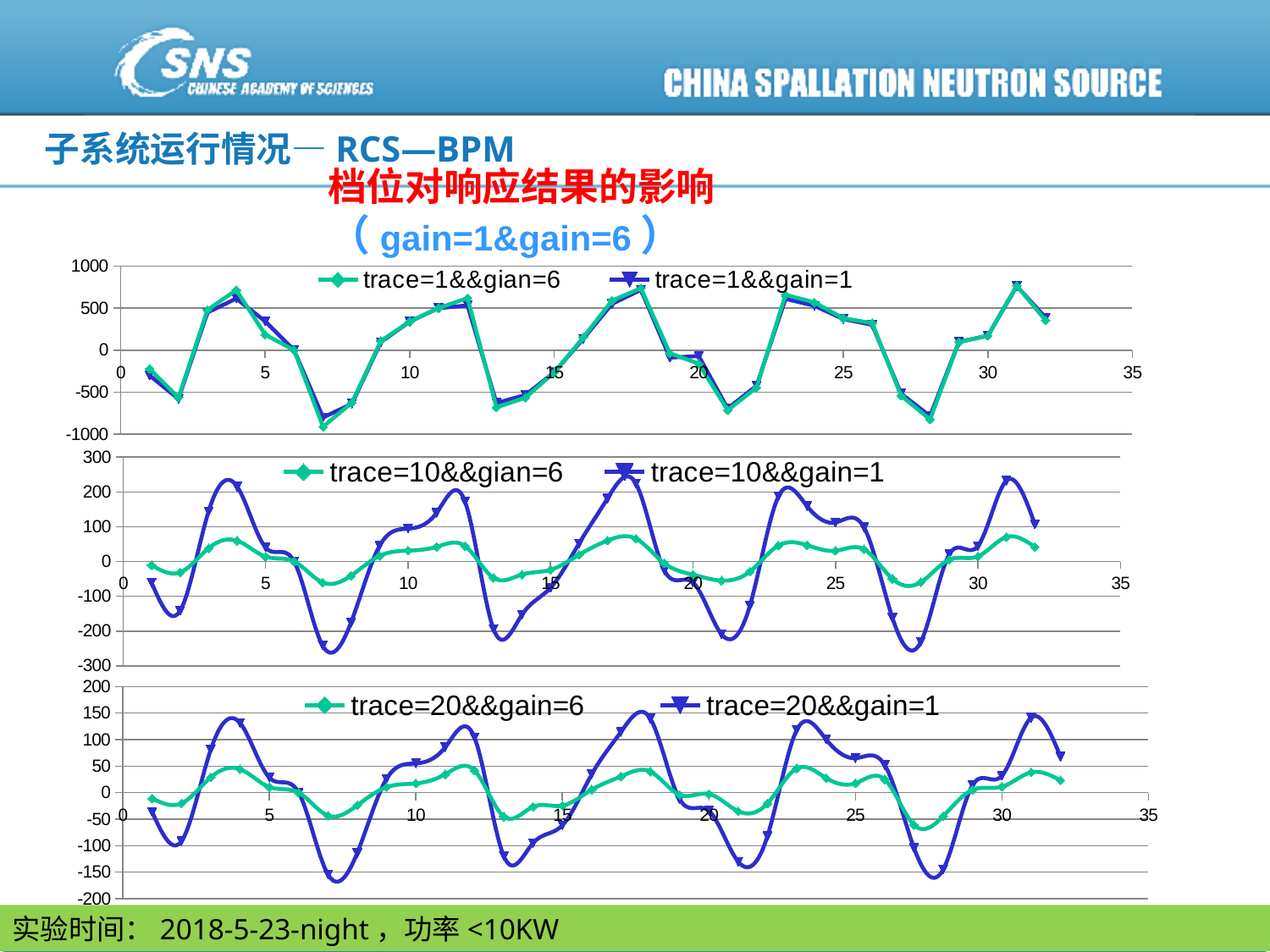
In the bottom chart, is the lowest value of the trace=20&&gain=1 series near x=27 greater or less than -100? less In the bottom chart, which series reaches the higher peak value: trace=20&&gain=6 or trace=20&&gain=1? trace=20&&gain=1 What kind of chart is the top chart on the slide? line chart How many series does the legend of the middle chart list? 2 In the bottom chart, what are the two series named in the legend? trace=20&&gain=6 and trace=20&&gain=1 In the middle chart, is the highest value of the trace=10&&gian=6 series greater or less than 100? less In the middle chart, at x=3, which series has the larger value: trace=10&&gain=1 or trace=10&&gian=6? trace=10&&gain=1 In the middle chart, is the peak value of the trace=10&&gain=1 series near x=18 greater or less than 200? greater How many charts are shown on the slide? 3 In the top chart, what is the maximum value shown on the vertical axis? 1000